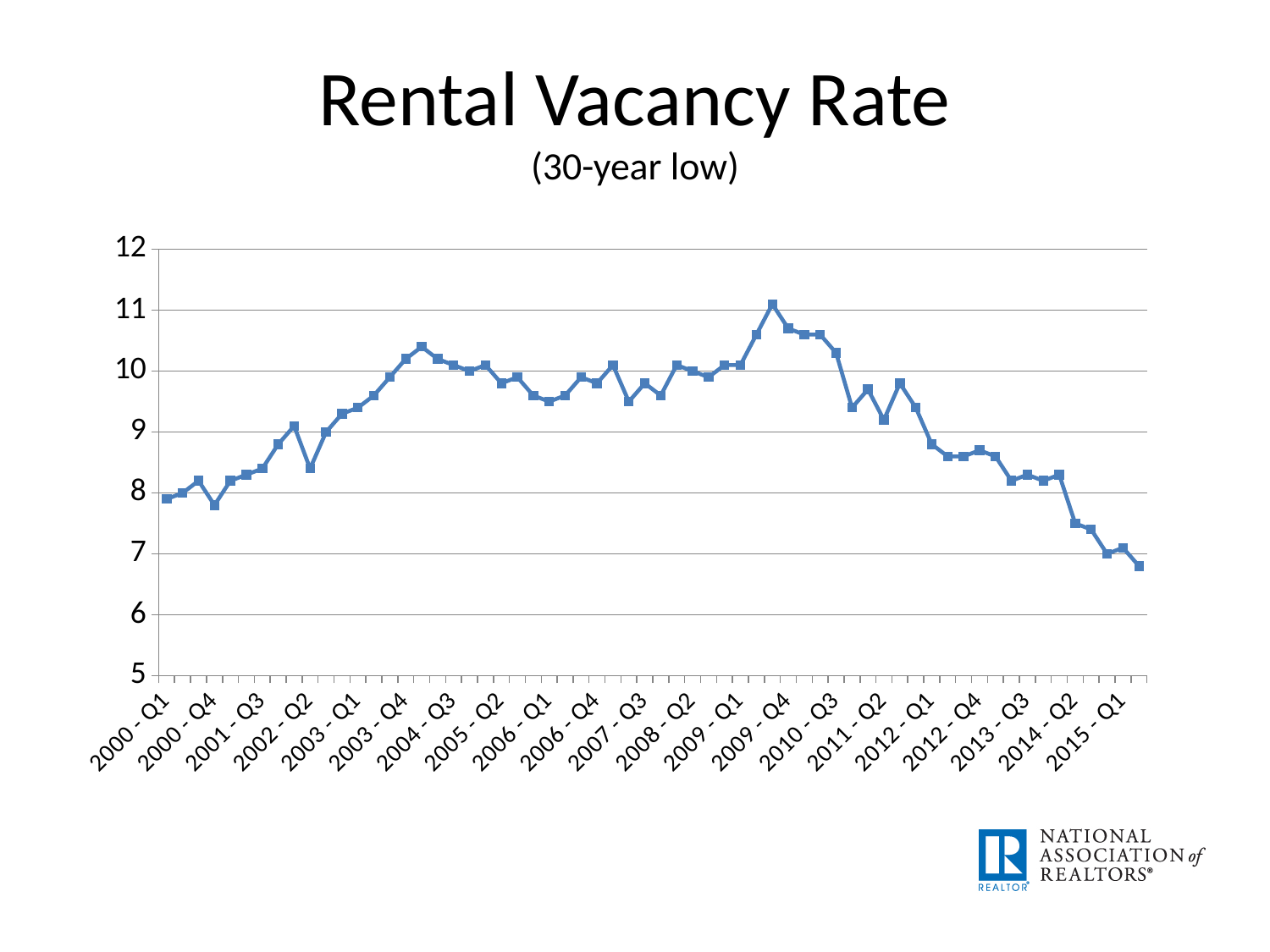
Which is larger, the value for 2000 - Q1 or the value for 2004 - Q1? 2004 - Q1 Is the value for 2010 - Q3 greater or less than 10? greater Is the value for 2009 - Q4 greater or less than 10? greater What does the subtitle under the chart title say? (30-year low) What kind of chart is shown on the slide? line chart Is the value for 2012 - Q4 greater or less than 9? less Does the rental vacancy rate rise or fall between 2009 - Q4 and 2015 - Q1? fall What is the title of the chart on the slide? Rental Vacancy Rate Which is larger, the value for 2009 - Q4 or the value for 2015 - Q1? 2009 - Q4